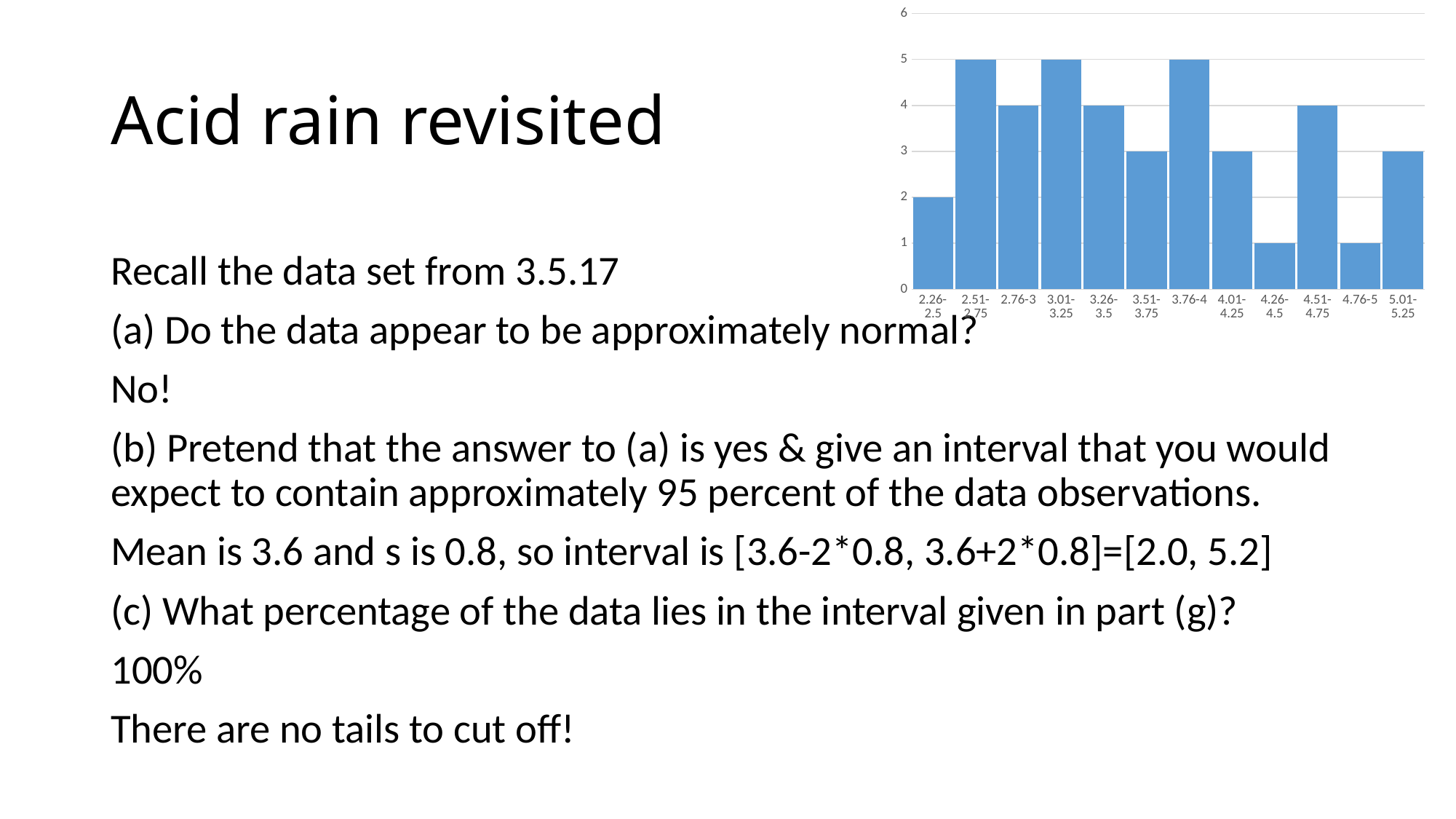
What is the value for the 2.26-2.5 bin? 2 What is the value for the 4.51-4.75 bin? 4 What is the value for the 5.01-5.25 bin? 3 What is the value for the 4.26-4.5 bin? 1 What kind of chart is shown on the slide? bar chart What is the value for the 3.51-3.75 bin? 3 What is the highest value reached by any bar in the chart? 5 How many categories (bins) are shown on the x axis of the chart? 12 Is the value for the 2.76-3 bin greater or less than 3? greater Which bins have the lowest value in the chart? 4.26-4.5 and 4.76-5 What is the difference between the values for the 2.51-2.75 bin and the 2.26-2.5 bin? 3 Which is larger, the value for the 3.76-4 bin or the value for the 4.01-4.25 bin? 3.76-4